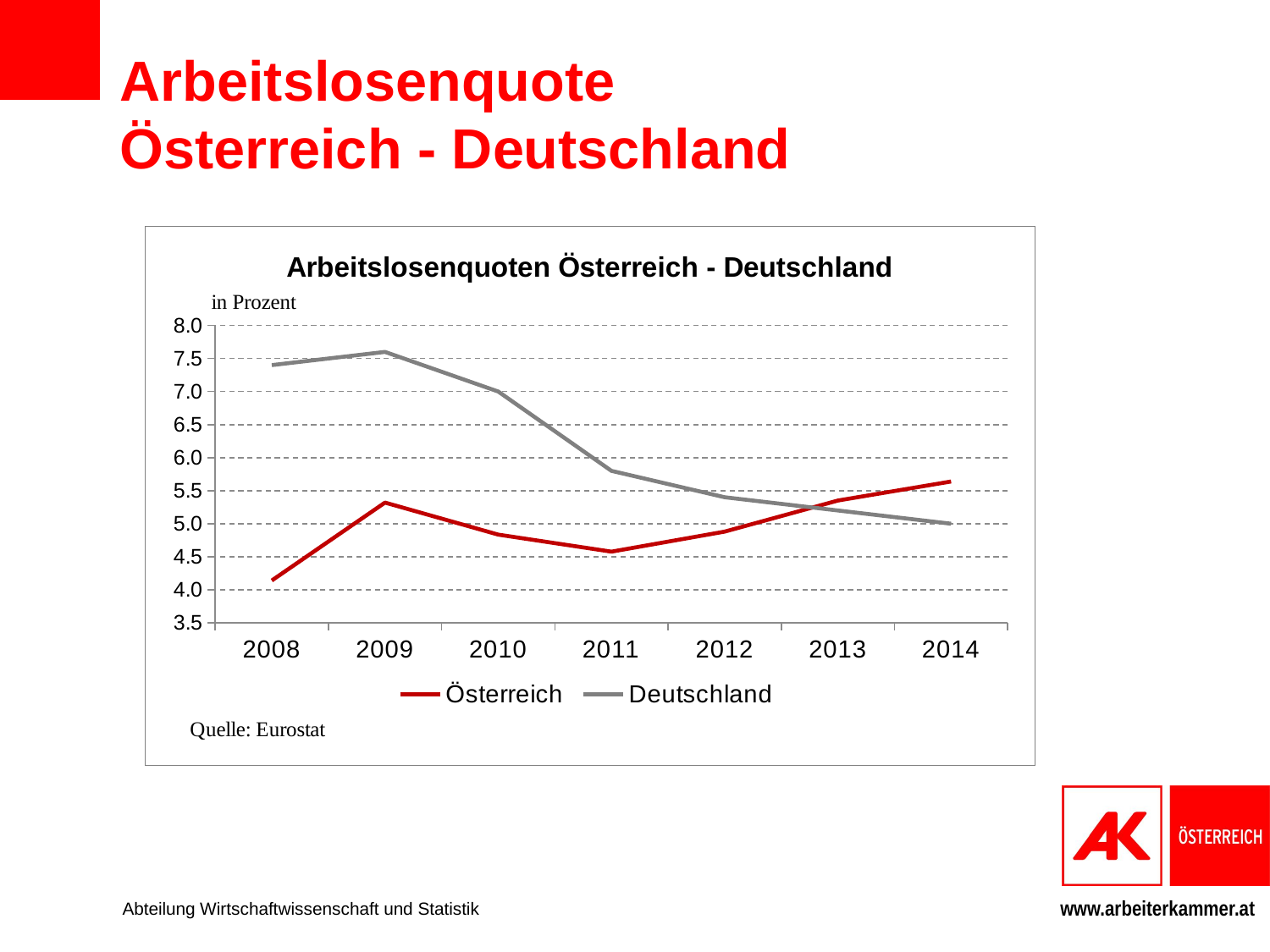
Does the value for Deutschland rise or fall from 2009 to 2014? fall In which year is the value for Deutschland highest? 2009 In 2008, which is larger, the value for Österreich or for Deutschland? Deutschland Which series is drawn in red? Österreich Is the value for Deutschland in 2008 greater or less than 7.0? greater In which year is the value for Österreich lowest? 2008 How many years are shown on the x axis? 7 What is the title of the chart? Arbeitslosenquoten Österreich - Deutschland In 2014, which is larger, the value for Österreich or for Deutschland? Österreich What kind of chart is shown on the slide? line chart Is the value for Österreich in 2011 greater or less than 5.0? less How many series does the legend list? 2